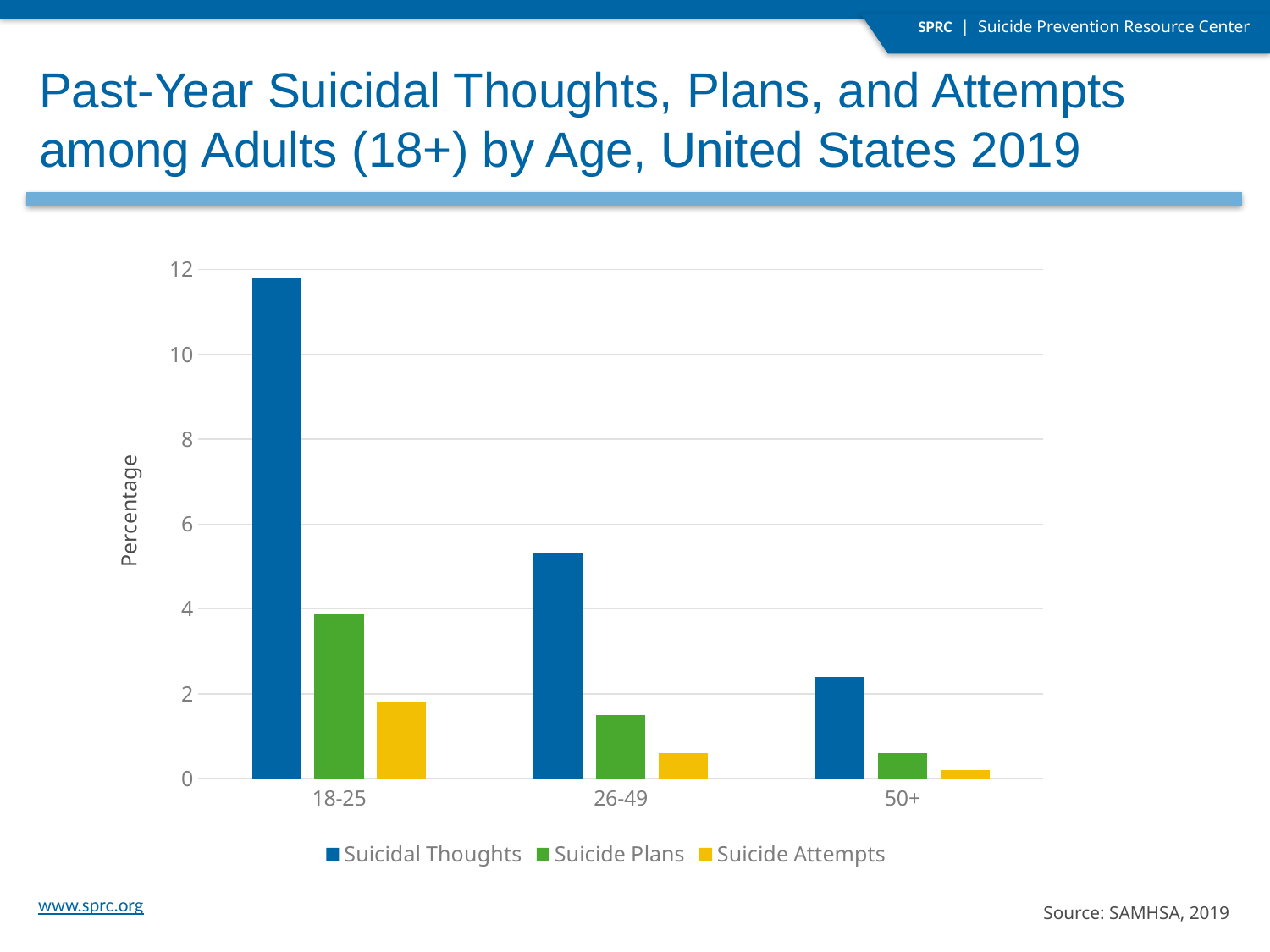
Which age group has the highest value for Suicidal Thoughts? 18-25 Which age group has the lowest value for Suicide Attempts? 50+ Is the value for Suicidal Thoughts in the 18-25 age group greater or less than 10? greater Which colour represents Suicide Attempts in the legend? yellow Is the value for Suicidal Thoughts in the 26-49 age group greater or less than 6? less Which is larger: Suicide Plans for 26-49 or Suicide Attempts for 18-25? Suicide Attempts for 18-25 What kind of chart is shown on the slide? bar chart What is the label on the y axis? Percentage Is the value for Suicide Plans in the 18-25 age group greater or less than 2? greater How many age groups are shown on the x axis? 3 How many series does the legend list? 3 Do the Suicidal Thoughts values rise or fall as age increases along the x axis? fall